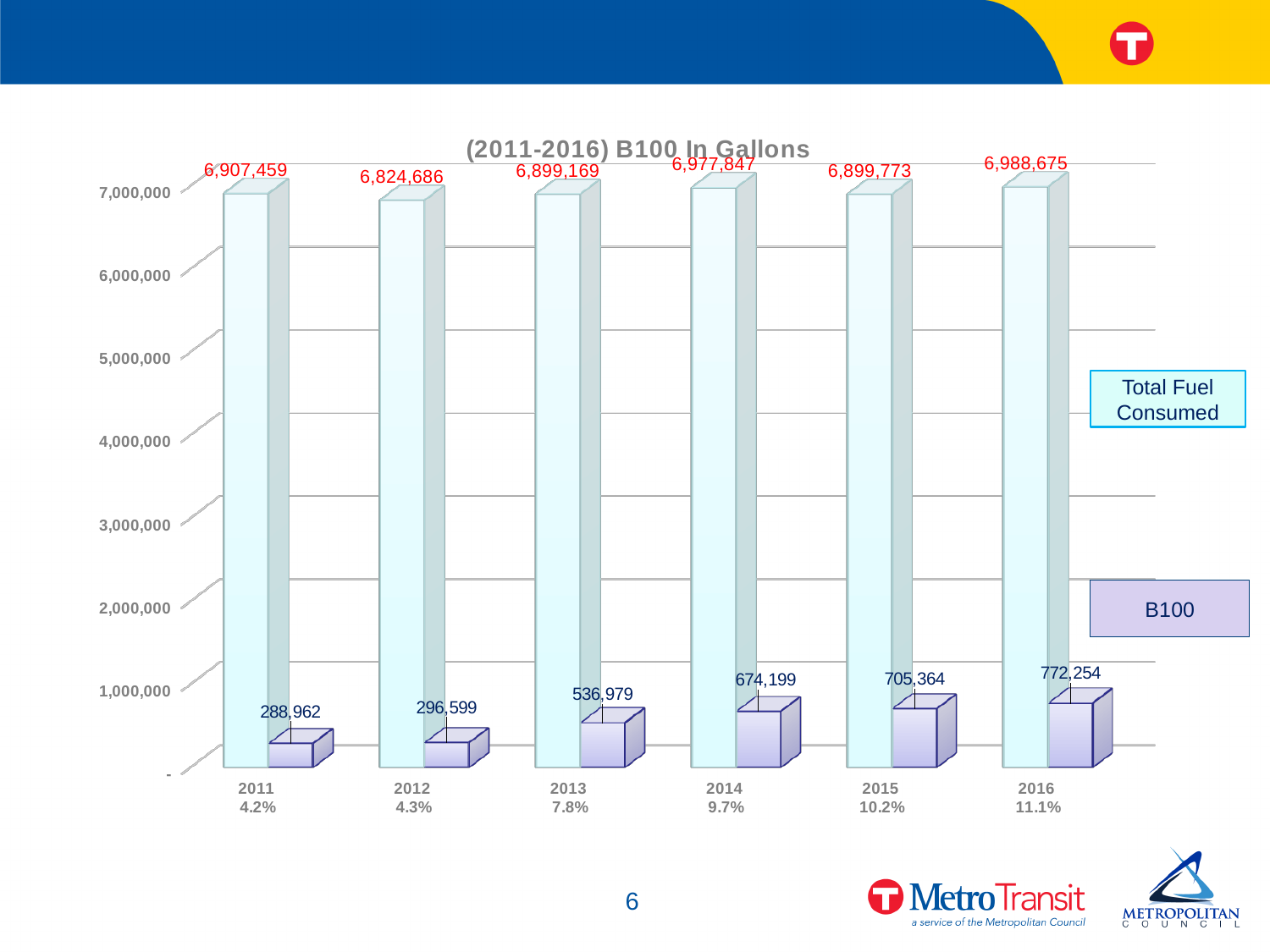
What is the difference between the B100 values for 2016 and 2011? 483,292 Which year has the highest B100 value? 2016 What percentage is shown under the 2015 category label? 10.2% What is the B100 value for 2014? 674,199 Is the B100 value for 2016 greater or less than 1,000,000? less What is the Total Fuel Consumed value for 2012? 6,824,686 Which year has the lowest B100 value? 2011 What kind of chart is shown on the slide? Bar chart Which is larger, the B100 value for 2013 or for 2012? 2013 How many years are shown on the x axis? 6 How many series does the legend list? 2 What is the difference between the B100 values for 2015 and 2014? 31,165